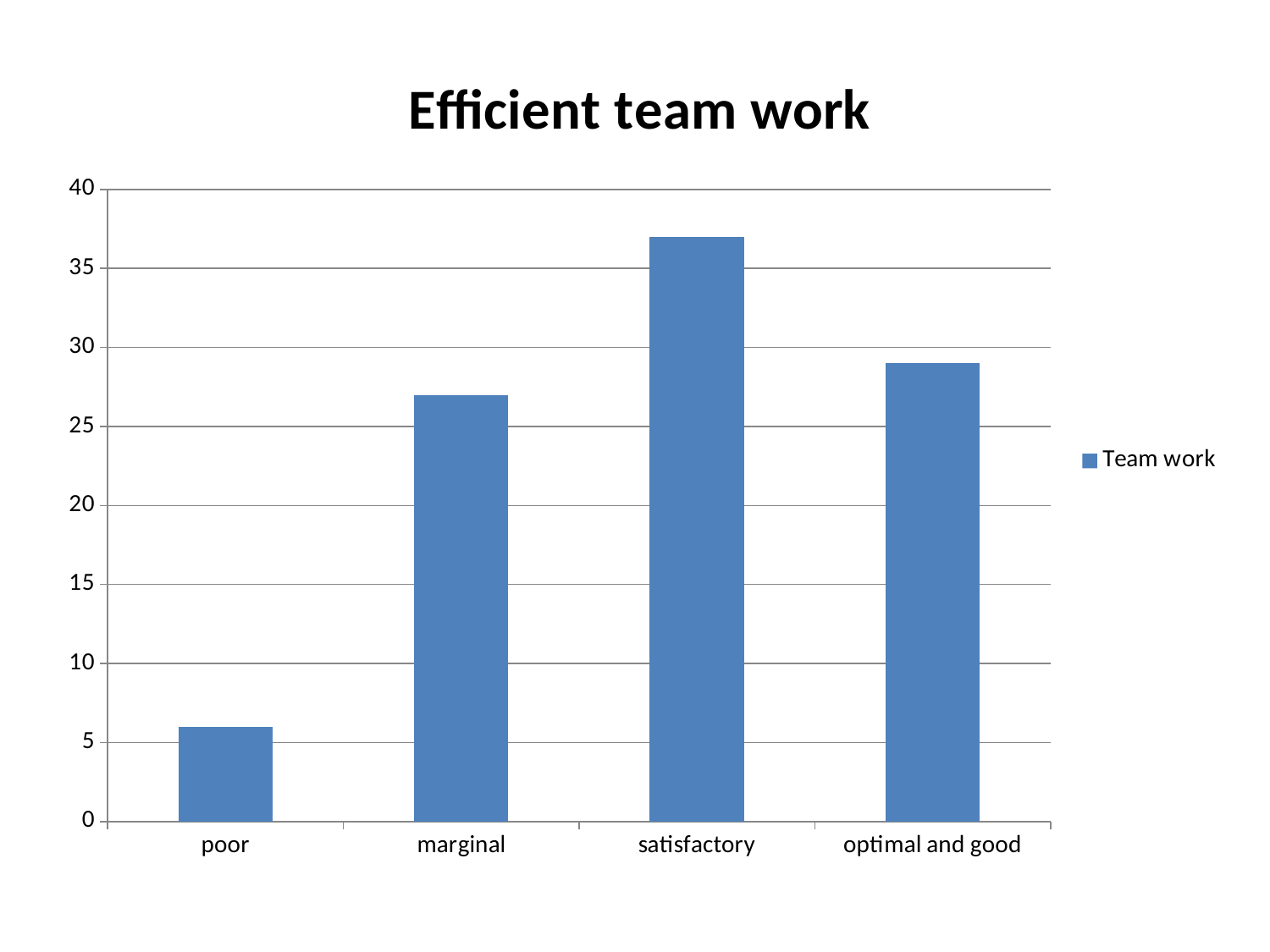
How many categories are shown on the x axis? 4 Is the value for marginal greater or less than 25? greater How many series does the legend list? 1 Which is larger, the value for marginal or the value for optimal and good? optimal and good Which category has the highest value? satisfactory What is the name of the series shown in the legend? Team work Is the value for poor greater or less than 10? less Which category has the lowest value? poor What kind of chart is shown on the slide? bar chart What is the title of the chart? Efficient team work Is the value for satisfactory greater or less than 35? greater